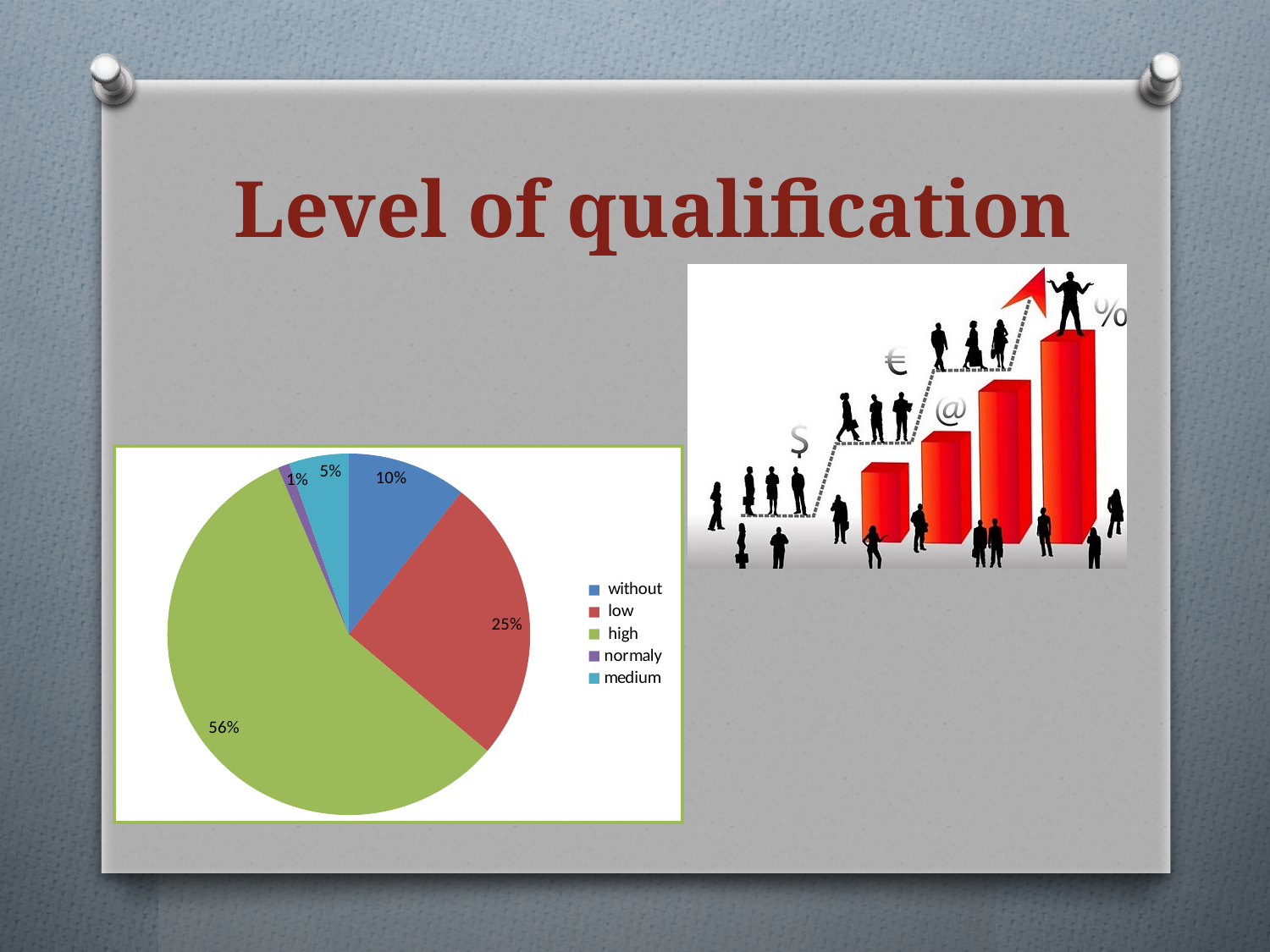
Which category has the largest slice of the pie? high Which category has the smallest slice of the pie? normaly How many categories does the pie chart legend list? 5 What is the difference between the "high" and "low" slices? 31% What colour is the "high" slice in the pie chart? green What kind of chart is shown on the slide? pie chart What is the value shown for the "medium" slice? 5% What is the value shown for the "normaly" slice? 1% Which is larger, the "without" slice or the "medium" slice? without What share of the pie does the "high" slice represent? 56% What is the value shown for the "low" slice? 25% What is the value shown for the "without" slice? 10%